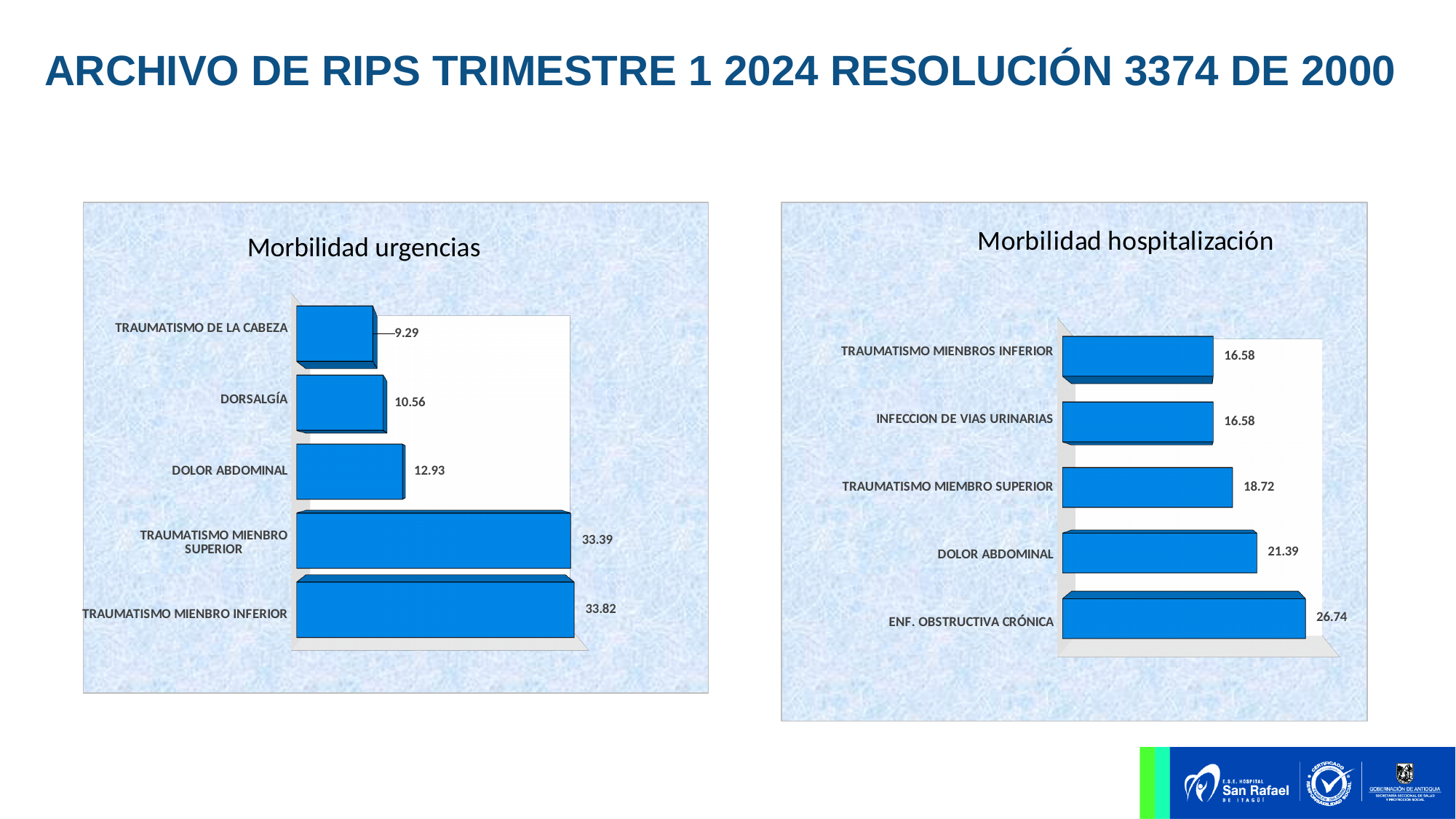
In the 'Morbilidad hospitalización' chart, what is the value for ENF. OBSTRUCTIVA CRÓNICA? 26.74 In the 'Morbilidad urgencias' chart, which category has the highest value? TRAUMATISMO MIENBRO INFERIOR In the 'Morbilidad urgencias' chart, what is the value for DOLOR ABDOMINAL? 12.93 In the 'Morbilidad urgencias' chart, what is the value for DORSALGÍA? 10.56 Which is larger: DOLOR ABDOMINAL in the 'Morbilidad urgencias' chart or DOLOR ABDOMINAL in the 'Morbilidad hospitalización' chart? Morbilidad hospitalización How many categories are shown in the 'Morbilidad urgencias' chart? 5 In the 'Morbilidad urgencias' chart, what is the difference between TRAUMATISMO MIENBRO INFERIOR and TRAUMATISMO MIENBRO SUPERIOR? 0.43 In the 'Morbilidad hospitalización' chart, what is the value for INFECCION DE VIAS URINARIAS? 16.58 In the 'Morbilidad hospitalización' chart, which category has the highest value? ENF. OBSTRUCTIVA CRÓNICA In the 'Morbilidad hospitalización' chart, what is the difference between DOLOR ABDOMINAL and TRAUMATISMO MIEMBRO SUPERIOR? 2.67 In the 'Morbilidad urgencias' chart, which category has the lowest value? TRAUMATISMO DE LA CABEZA What type of chart is the 'Morbilidad hospitalización' chart? Bar chart